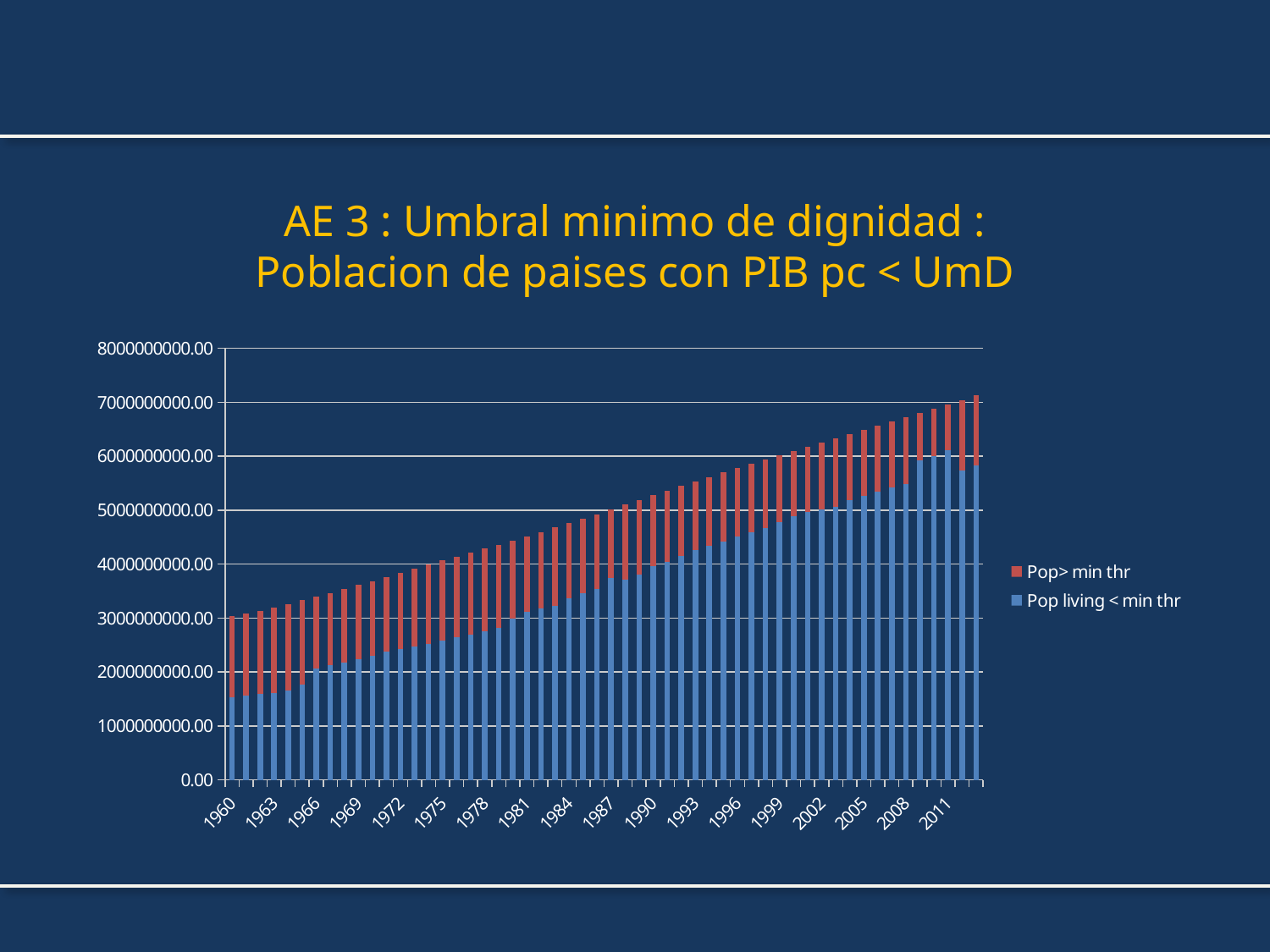
How many series does the legend list? 2 What kind of chart is shown on the slide? stacked bar chart Is the value for Pop living < min thr in 1960 greater or less than 2000000000.00? less What is the title of the chart? AE 3 : Umbral minimo de dignidad : Poblacion de paises con PIB pc < UmD Do the values for Pop living < min thr rise or fall from 1960 to 2011? rise What are the two series named in the legend? Pop> min thr and Pop living < min thr Is the value for Pop living < min thr in 1975 greater or less than 3000000000.00? less Is the total stacked bar for 1984 greater or less than 5000000000.00? less Which is larger, the Pop living < min thr value in 1960 or in 2011? 2011 Does the total height of the stacked bars rise or fall along the x axis from 1960 onward? rise